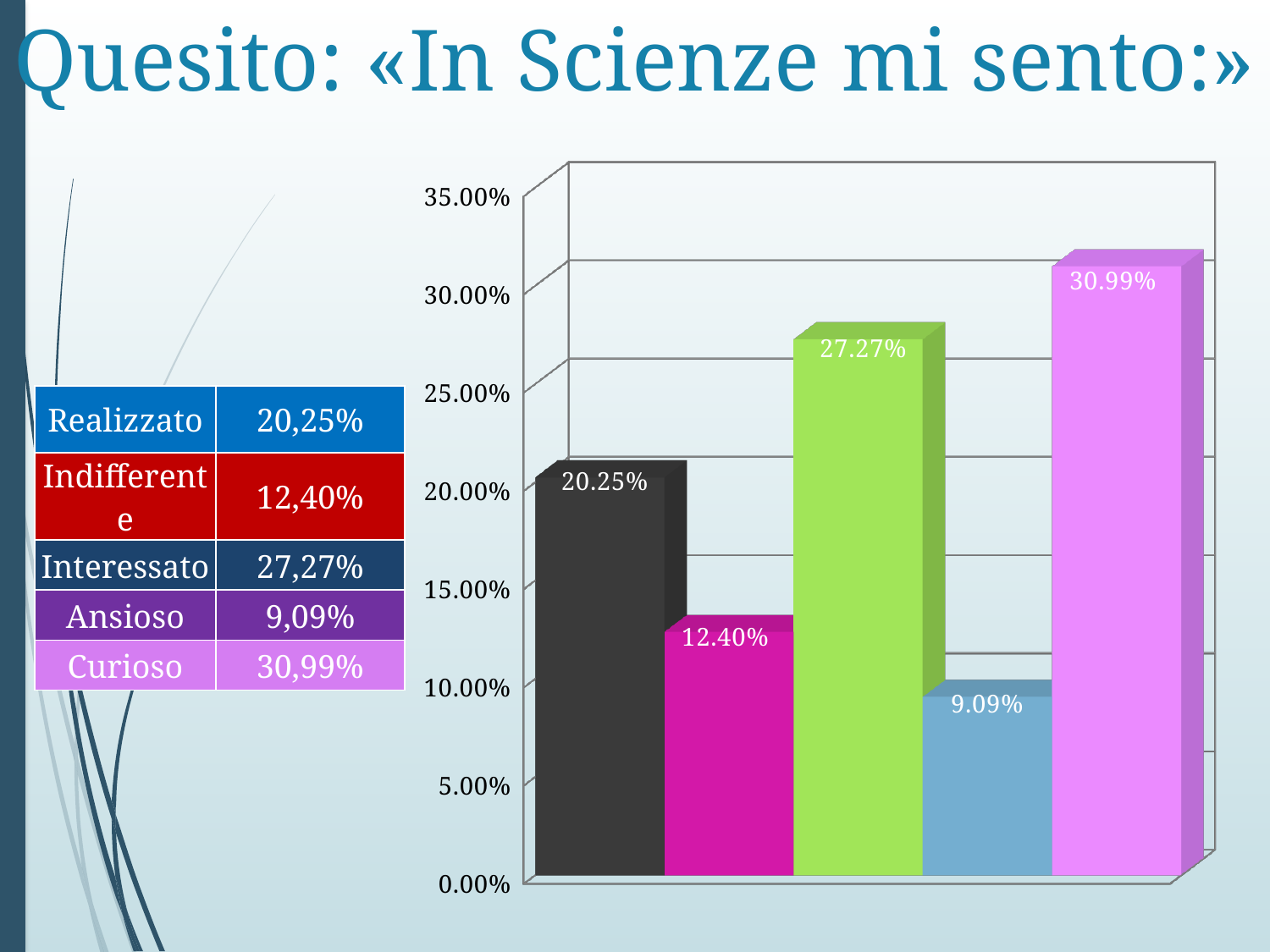
What is the highest value shown on the vertical axis of the chart? 35.00% Which is larger, the value of the second bar (12.40%) or the fourth bar (9.09%)? the second bar (12.40%) According to the table, which category has the lowest percentage? Ansioso What is the data label on the first (leftmost) bar of the chart? 20.25% What percentage does the table give for Indifferente? 12,40% What is the data label on the tallest bar in the chart? 30.99% What is the difference between the data labels of the fifth bar (30.99%) and the first bar (20.25%)? 10.74% What is the data label on the shortest bar in the chart? 9.09% According to the table, which category has the highest percentage? Curioso What is the data label on the third bar of the chart? 27.27% How many bars are plotted in the chart? 5 What kind of chart is shown on the slide? bar chart